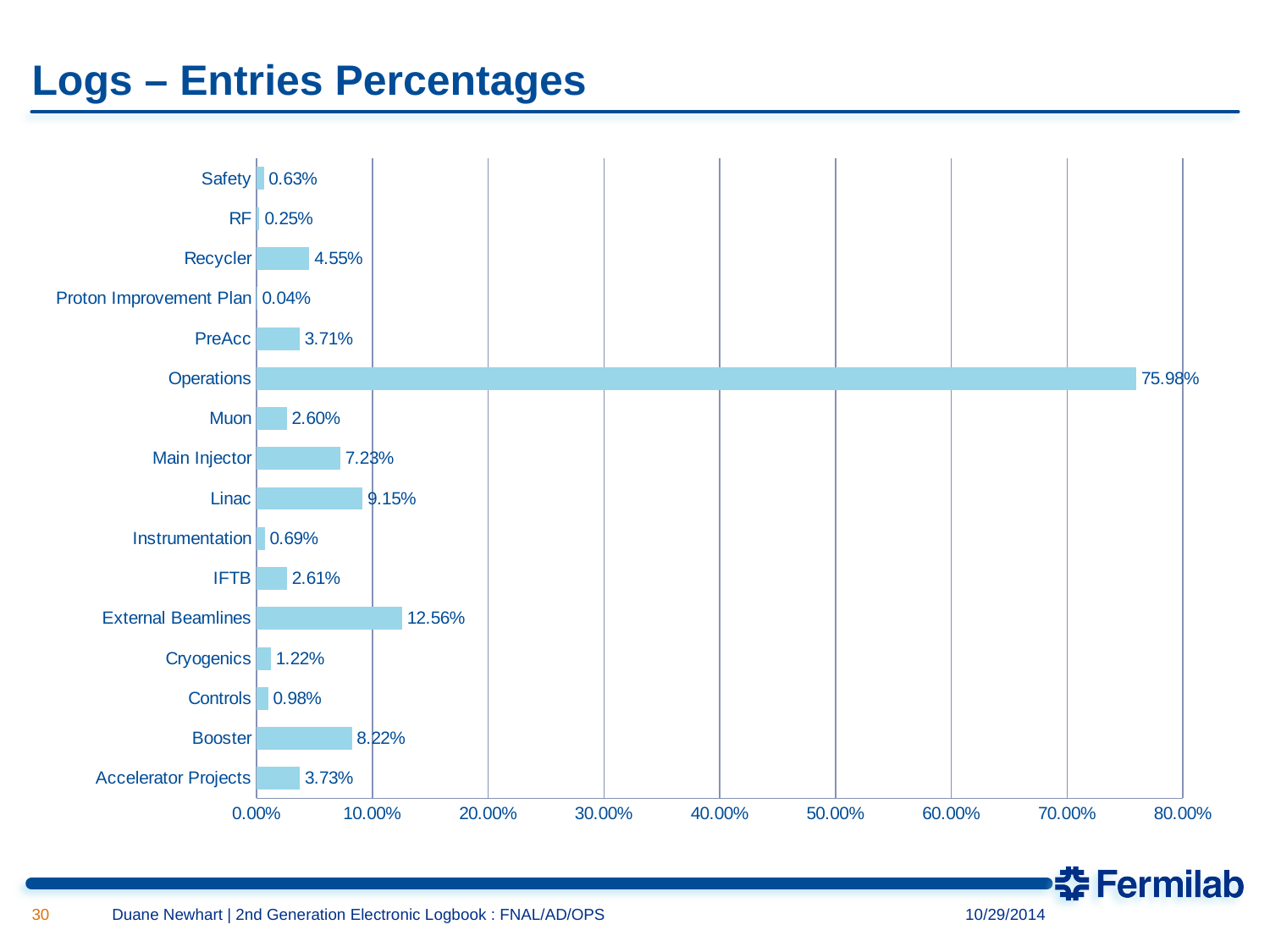
What is the value for Proton Improvement Plan? 0.04% Which category has the lowest value? Proton Improvement Plan Which is larger, the value for Recycler or the value for PreAcc? Recycler What kind of chart is shown on the slide? bar chart What is the difference between the values for Main Injector and Muon? 4.63% What is the difference between the values for Operations and External Beamlines? 63.42% What is the value for Operations? 75.98% Is the value for Operations greater or less than 70.00%? greater How many categories are shown in the chart? 16 What is the value for Linac? 9.15% Which category has the highest value? Operations What is the value for External Beamlines? 12.56%